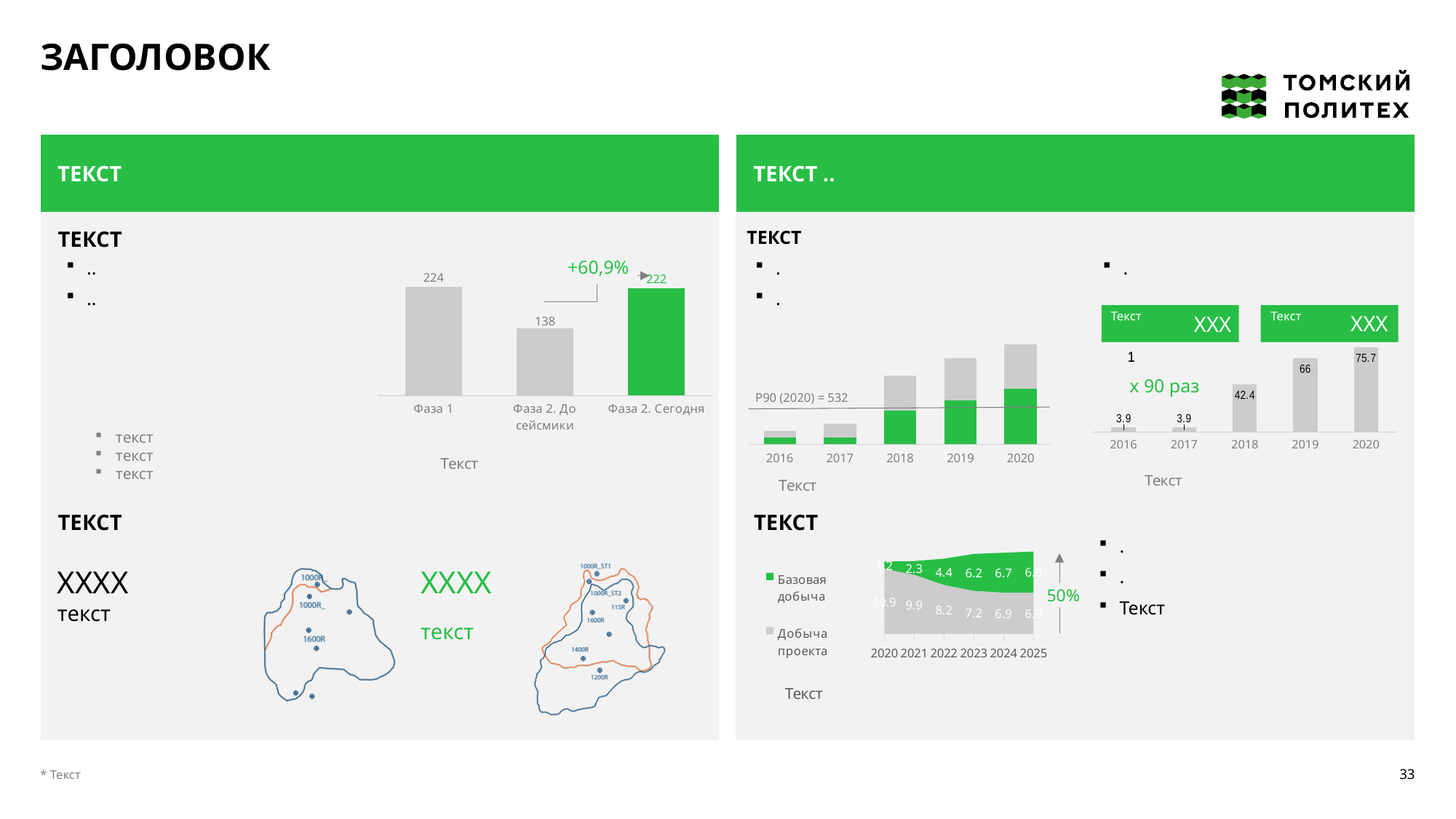
In the bar chart at the top right of the right panel (2016–2020 with data labels), which year has the highest value? 2020 How many series does the legend list for the area chart at the bottom of the right panel (2020–2025)? 2 In the bar chart in the left panel (phases), what is the difference between Фаза 1 and Фаза 2. До сейсмики? 86 In the bar chart at the top right of the right panel (2016–2020 with data labels), what is the value for 2018? 42.4 In the bar chart in the left panel (phases), what is the value for Фаза 1? 224 In the bar chart in the left panel (phases), what is the value for Фаза 2. До сейсмики? 138 In the stacked bar chart at the top left of the right panel (2016–2020), how many years are shown on the x axis? 5 In the bar chart in the left panel (phases), which category has the lowest value? Фаза 2. До сейсмики In the bar chart in the left panel (phases), what percentage change is annotated above the bars? +60,9% In the area chart at the bottom of the right panel (2020–2025), what is the value of Базовая добыча in 2023? 6.2 In the bar chart at the top right of the right panel (2016–2020 with data labels), do the values rise or fall from 2016 to 2020? rise In the bar chart at the top right of the right panel (2016–2020 with data labels), what is the difference between 2020 and 2019? 9.7